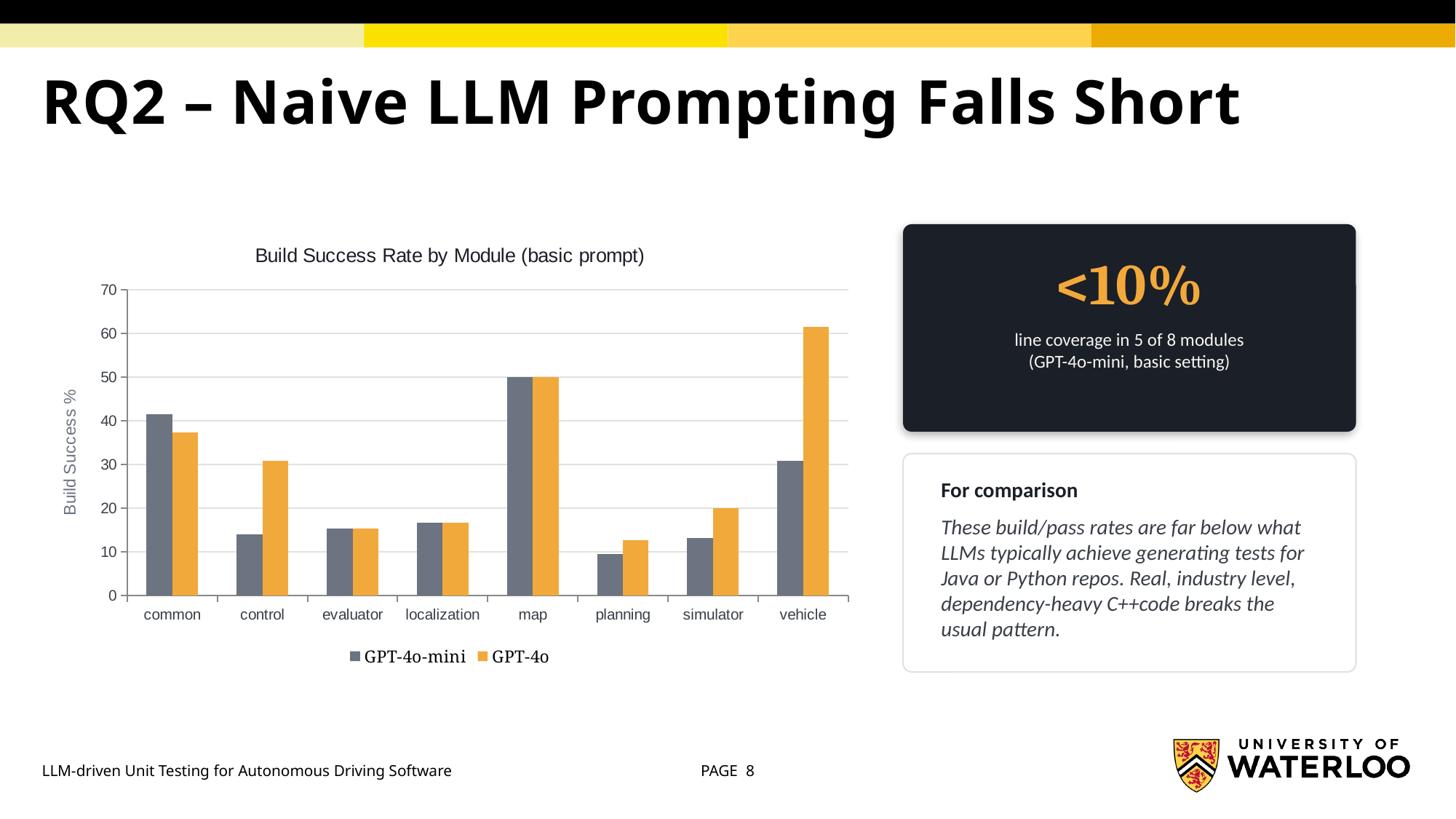
Is the build success rate for GPT-4o-mini on the control module greater or less than 20? less For the common module, which series has the higher build success rate, GPT-4o-mini or GPT-4o? GPT-4o-mini What kind of chart is shown on the slide? bar chart Is the build success rate for GPT-4o on the vehicle module greater or less than 50? greater What is the build success rate for GPT-4o on the map module? 50 What is the title of the chart? Build Success Rate by Module (basic prompt) Which module has the highest build success rate for GPT-4o? vehicle For the vehicle module, which series has the higher build success rate, GPT-4o-mini or GPT-4o? GPT-4o How many modules are shown on the x axis of the chart? 8 How many series does the legend of the chart list? 2 Which module has the lowest build success rate for GPT-4o-mini? planning Which module has the highest build success rate for GPT-4o-mini? map